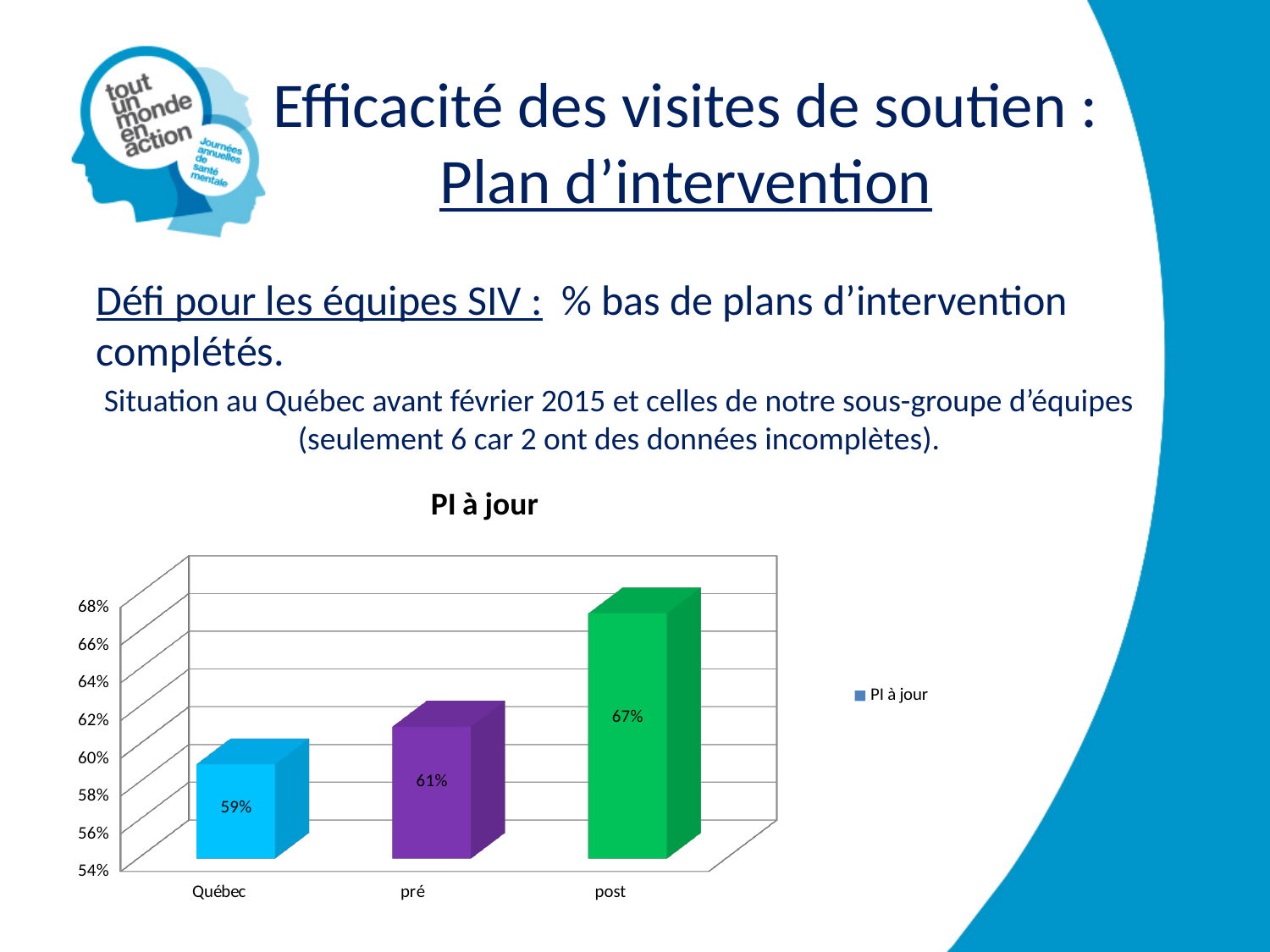
Which category has the highest value in the PI à jour chart? post How many categories are shown in the PI à jour chart? 3 Which is larger in the PI à jour chart, the value for post or the value for Québec? post What kind of chart is the PI à jour chart? bar chart Do the values in the PI à jour chart rise or fall from left to right? rise Is the value for post in the PI à jour chart greater or less than 64%? greater What is the value for pré in the PI à jour chart? 61% What is the value for Québec in the PI à jour chart? 59% What is the value for post in the PI à jour chart? 67% Which category has the lowest value in the PI à jour chart? Québec What is the difference between the post and pré values in the PI à jour chart? 6% What is the difference between the pré and Québec values in the PI à jour chart? 2%